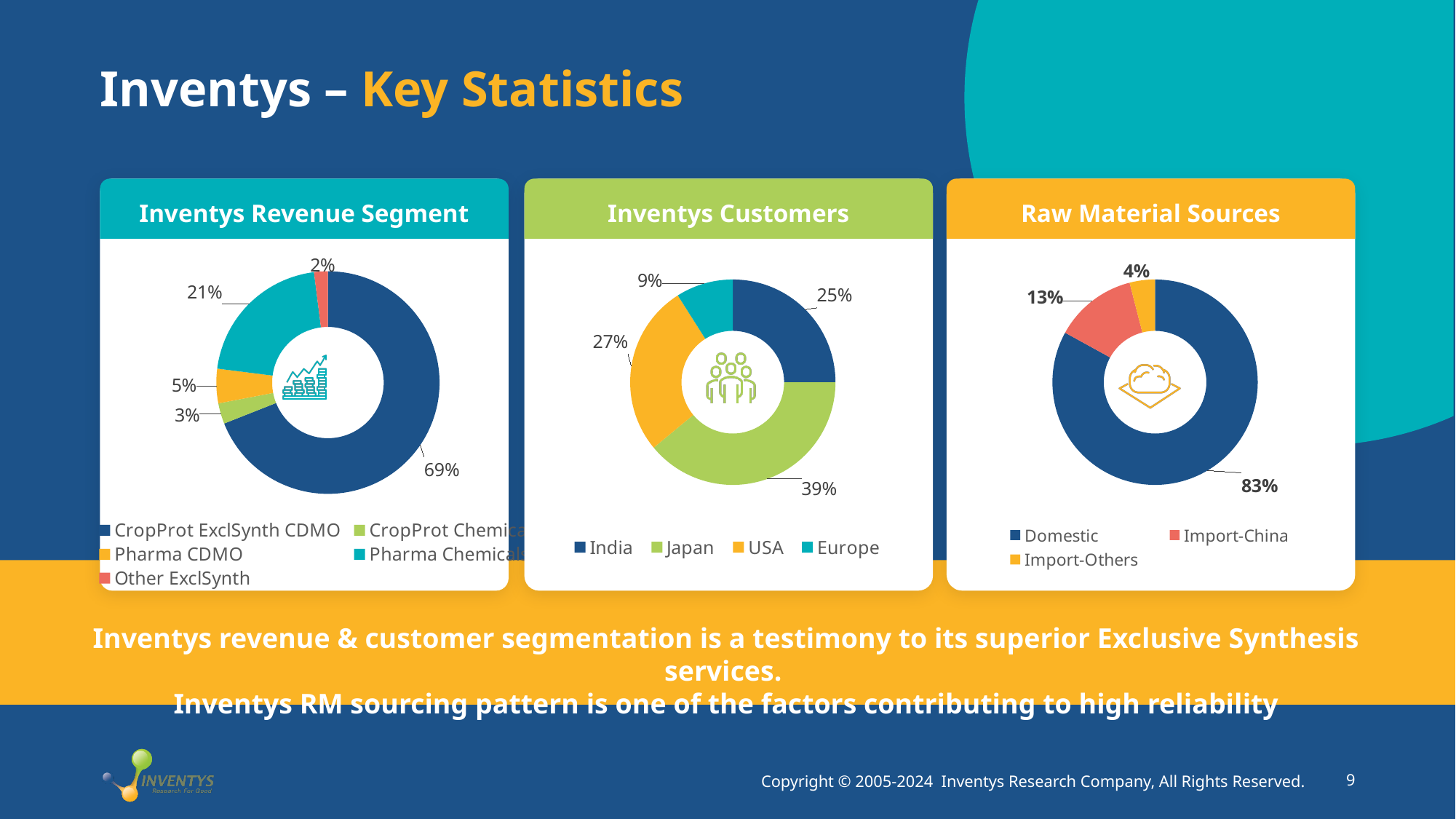
What type of chart is the Raw Material Sources chart? Donut (pie) chart In the Inventys Revenue Segment chart, how many segments are shown? 5 In the Inventys Customers chart, which region has the largest share of customers? Japan In the Inventys Revenue Segment chart, what share does CropProt ExclSynth CDMO have? 69% In the Inventys Revenue Segment chart, which segment has the smallest share? Other ExclSynth In the Inventys Revenue Segment chart, what share does Pharma CDMO have? 5% In the Raw Material Sources chart, which source is larger, Domestic or Import-Others? Domestic In the Inventys Customers chart, how many regions does the legend list? 4 In the Inventys Customers chart, what share do customers from Japan represent? 39% In the Raw Material Sources chart, what share comes from Import-China? 13% In the Inventys Customers chart, what is the difference between the USA share and the India share? 2% In the Inventys Customers chart, what share do customers from Europe represent? 9%